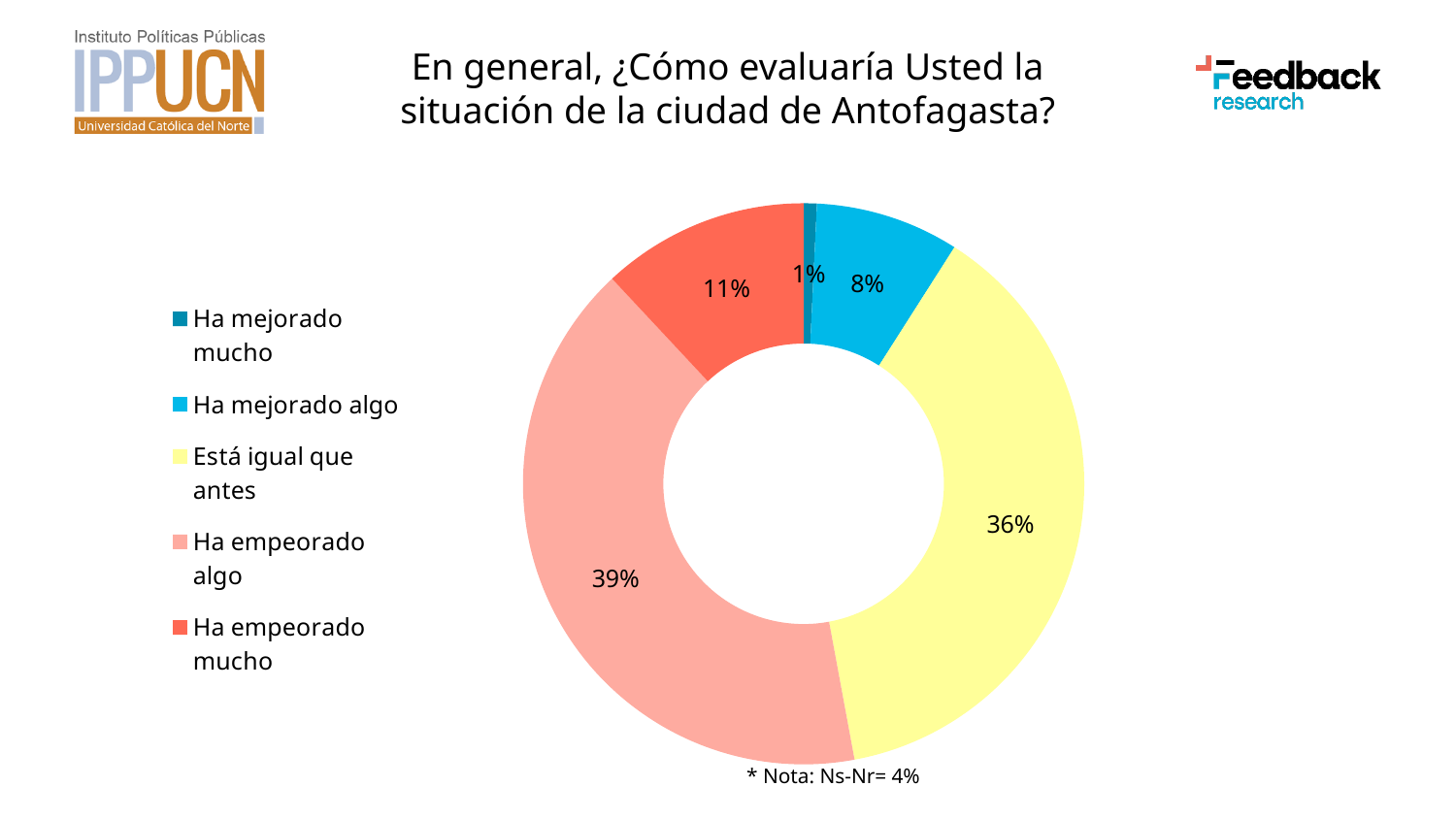
Which response category has the smallest share of the chart? Ha mejorado mucho Which is larger, the share for "Ha empeorado mucho" or the share for "Ha mejorado algo"? Ha empeorado mucho Which response category has the largest share of the chart? Ha empeorado algo What percentage of respondents answered "Ha mejorado algo"? 8% What percentage of respondents answered "Ha empeorado mucho"? 11% What is the difference in percentage points between "Ha empeorado algo" and "Está igual que antes"? 3 What percentage of respondents answered "Ha empeorado algo"? 39% How many response categories does the legend list? 5 What kind of chart is shown on the slide? Pie chart (donut) What percentage of respondents answered "Está igual que antes"? 36% According to the note below the chart, what is the Ns-Nr percentage? 4% What percentage of respondents answered "Ha mejorado mucho"? 1%